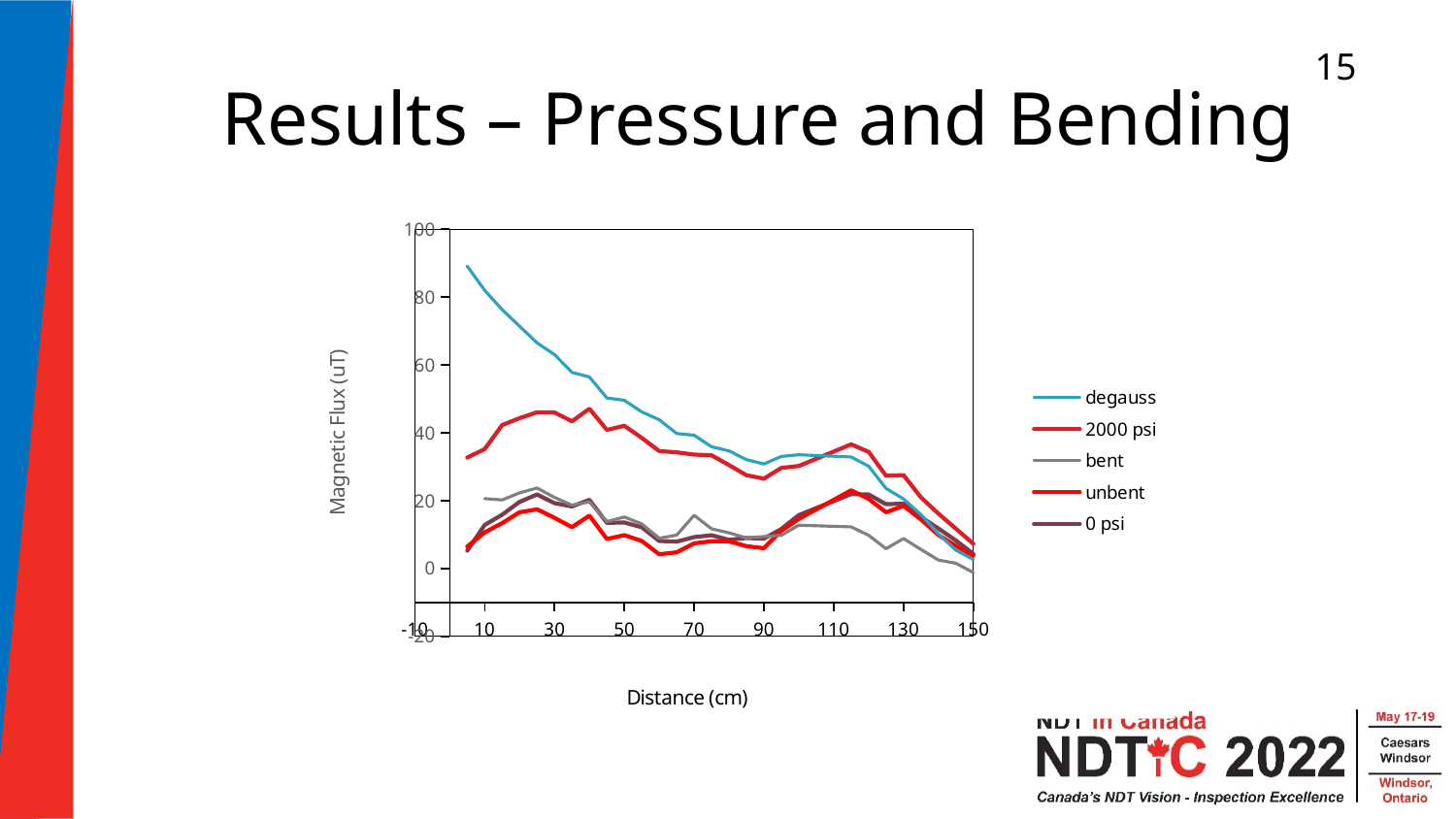
Is the value of the 2000 psi series at 30 cm greater or less than 40? greater Which series has the lowest value at 60 cm? unbent What is the label of the x axis? Distance (cm) What is the label of the y axis? Magnetic Flux (uT) Is the value of the unbent series at 60 cm greater or less than 20? less How many series does the legend list? 5 Which series has the highest value at 10 cm? degauss What kind of chart is shown on the slide? line chart Is the value of the degauss series at 150 cm greater or less than 20? less Does the degauss series rise or fall as distance increases? fall At 50 cm, which is larger: the degauss series or the 2000 psi series? degauss